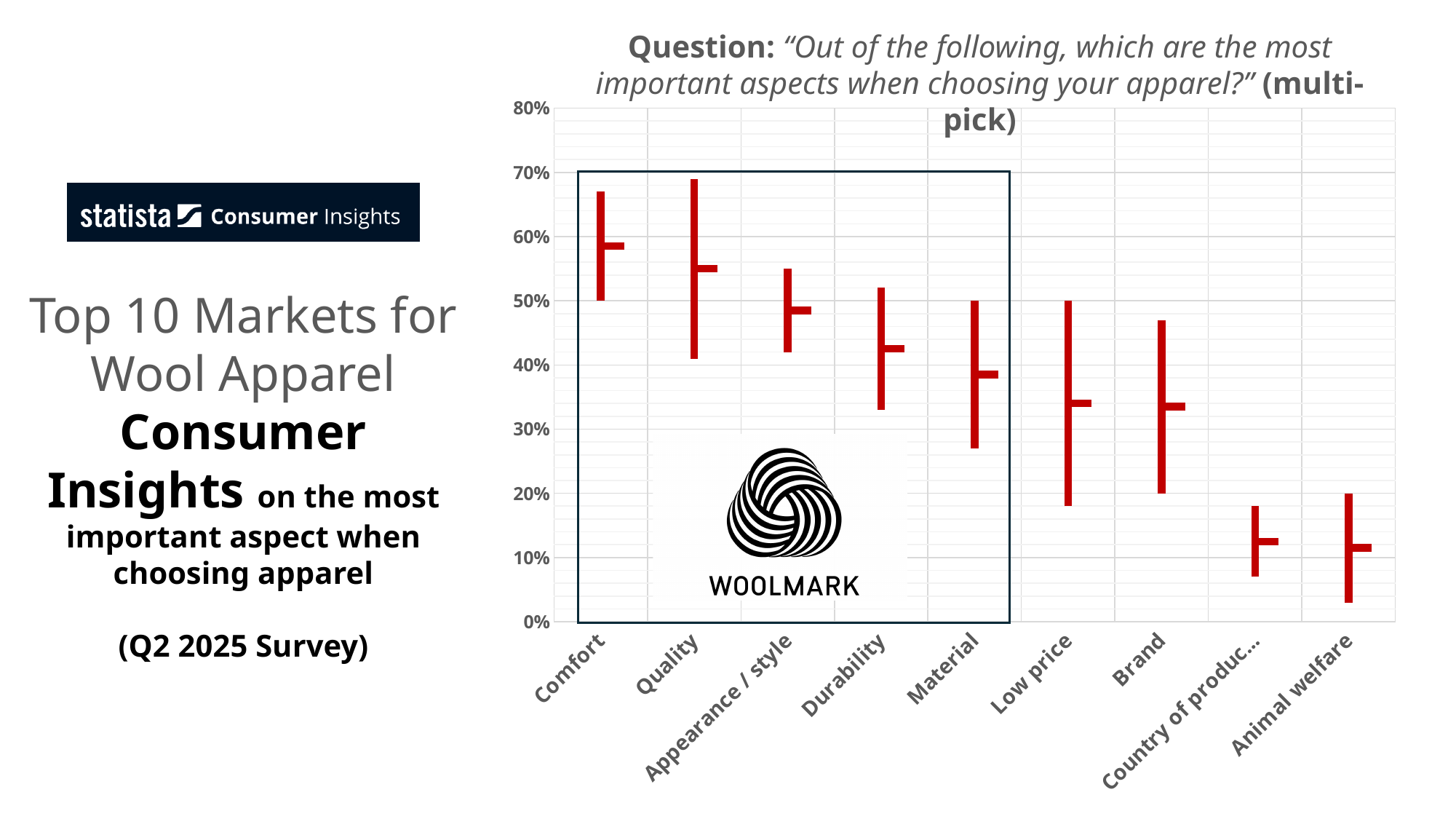
Which category has the highest marked value in the chart? Comfort Is the marked value for Material greater or less than 40%? less Is the marked value for Brand greater or less than 30%? greater Is the marked value for Animal welfare greater or less than 20%? less Which has the larger marked value, Durability or Brand? Durability What is the highest value shown on the chart's vertical axis? 80% How many categories are shown on the x axis of the chart? 9 Do the marked values generally rise or fall moving from left to right along the x axis? fall Which has the larger marked value, Comfort or Material? Comfort